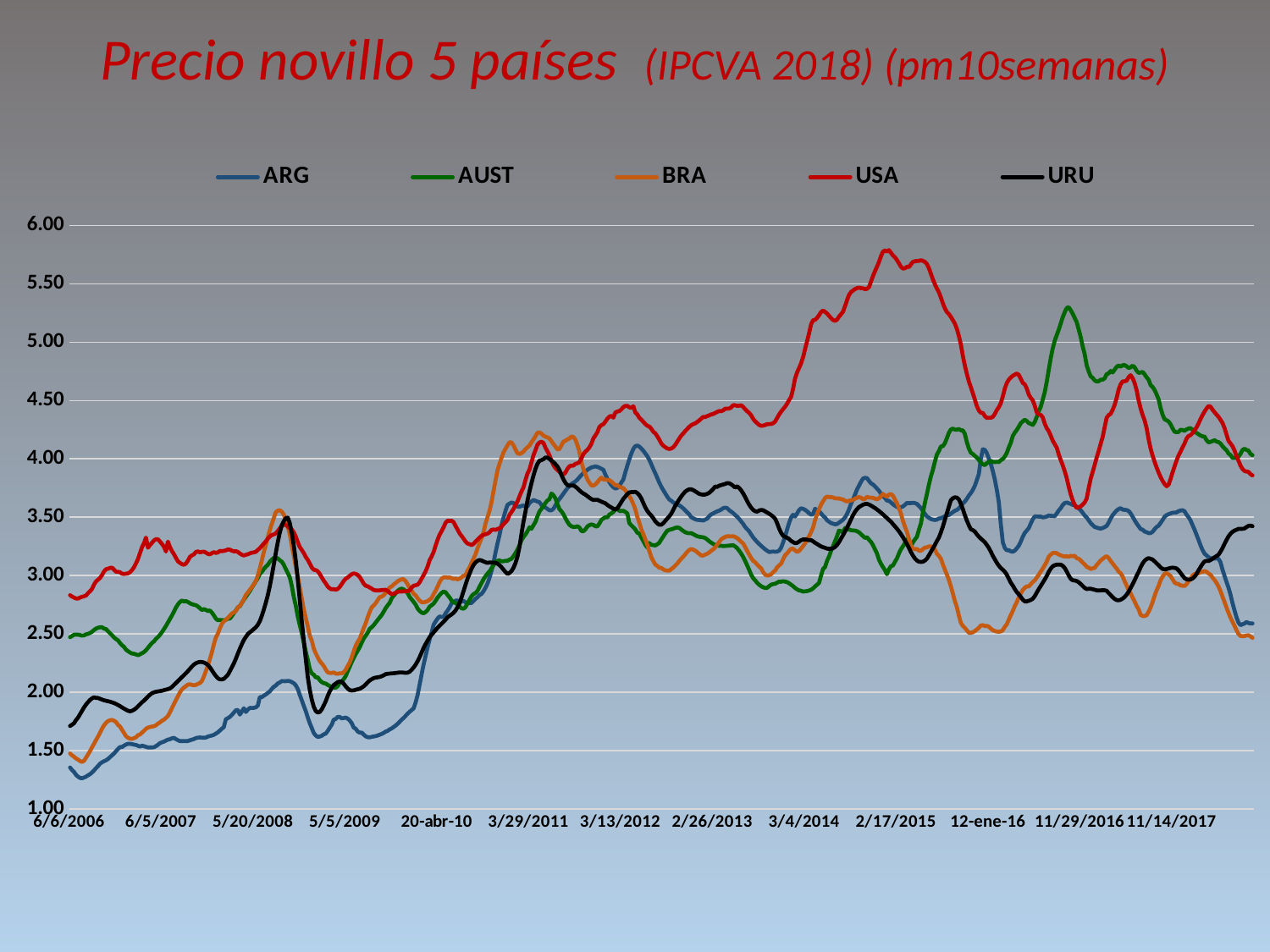
Does the ARG series generally rise or fall between 6/6/2006 and 3/29/2011? rise Is the peak value of the USA series greater or less than 5.50? greater Is the highest value of the AUST series greater or less than 5.00? greater How many date labels are shown on the x axis? 13 Around 2/17/2015, which is larger, the USA value or the URU value? USA Which series has the lowest value at the start of the chart (6/6/2006)? ARG Which series reaches the highest value anywhere on the chart? USA Is the value for BRA at 6/6/2006 greater or less than 2.00? less What colour is the USA line? red What kind of chart is shown on the slide? line chart How many series does the legend list? 5